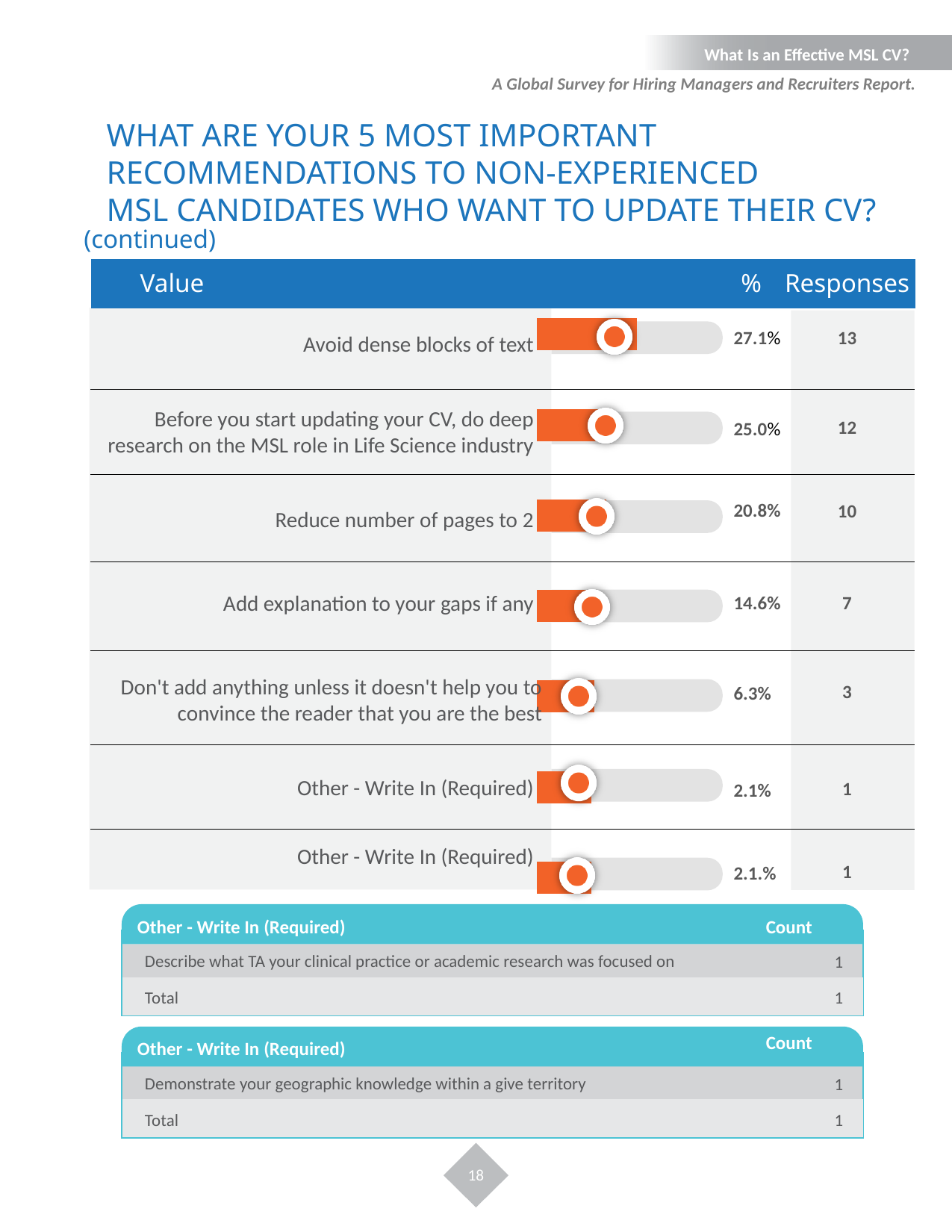
How many more responses did 'Avoid dense blocks of text' receive than 'Reduce number of pages to 2'? 3 How many responses did 'Before you start updating your CV, do deep research on the MSL role in Life Science industry' receive? 12 Do the percentages increase or decrease going down the rows of the chart? Decrease Which recommendation has the highest percentage? Avoid dense blocks of text Which named recommendation (excluding the 'Other - Write In' rows) has the lowest percentage? Don't add anything unless it doesn't help you to convince the reader that you are the best Which received more responses: 'Add explanation to your gaps if any' or 'Don't add anything unless it doesn't help you to convince the reader that you are the best'? Add explanation to your gaps if any How many responses did 'Reduce number of pages to 2' receive? 10 What percentage is shown for 'Add explanation to your gaps if any'? 14.6% What is the difference in percentage between 'Avoid dense blocks of text' and 'Before you start updating your CV, do deep research on the MSL role in Life Science industry'? 2.1% How many rows (recommendations) are listed in the chart? 7 What percentage of respondents recommended 'Avoid dense blocks of text'? 27.1% What kind of chart is used to show the percentages? Bar chart